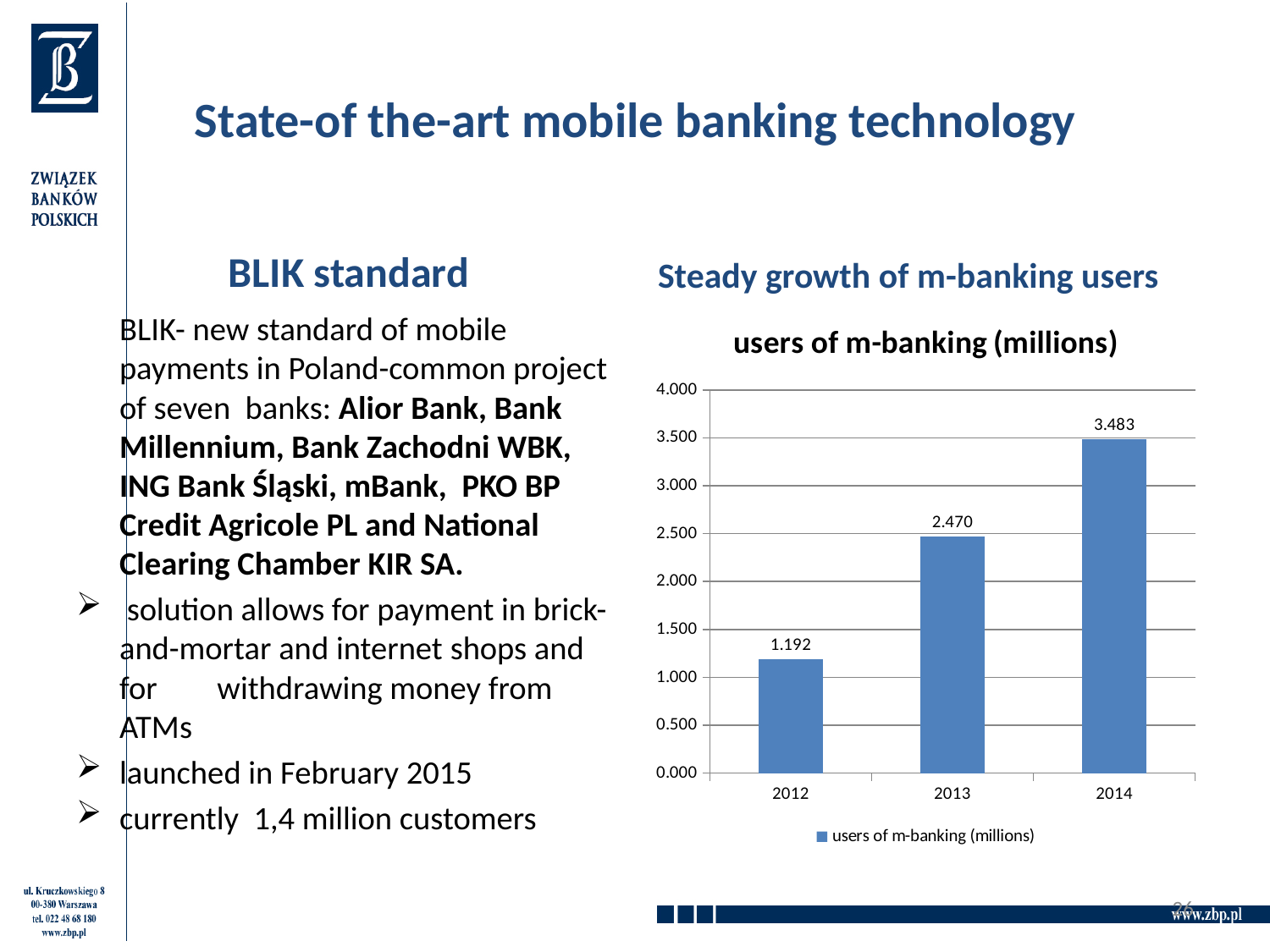
How many years are shown on the x axis of the users of m-banking (millions) chart? 3 What kind of chart is the users of m-banking (millions) chart? bar chart Which is larger in the users of m-banking (millions) chart, the value for 2012 or the value for 2013? 2013 Which year has the highest value in the users of m-banking (millions) chart? 2014 Which year has the lowest value in the users of m-banking (millions) chart? 2012 What is the value for 2014 in the users of m-banking (millions) chart? 3.483 Is the value for 2014 in the users of m-banking (millions) chart greater or less than 3.000? greater What is the difference between the 2014 and 2013 values in the users of m-banking (millions) chart? 1.013 What is the difference between the 2013 and 2012 values in the users of m-banking (millions) chart? 1.278 What is the value for 2012 in the users of m-banking (millions) chart? 1.192 What is the value for 2013 in the users of m-banking (millions) chart? 2.470 Do the values in the users of m-banking (millions) chart rise or fall from 2012 to 2014? rise